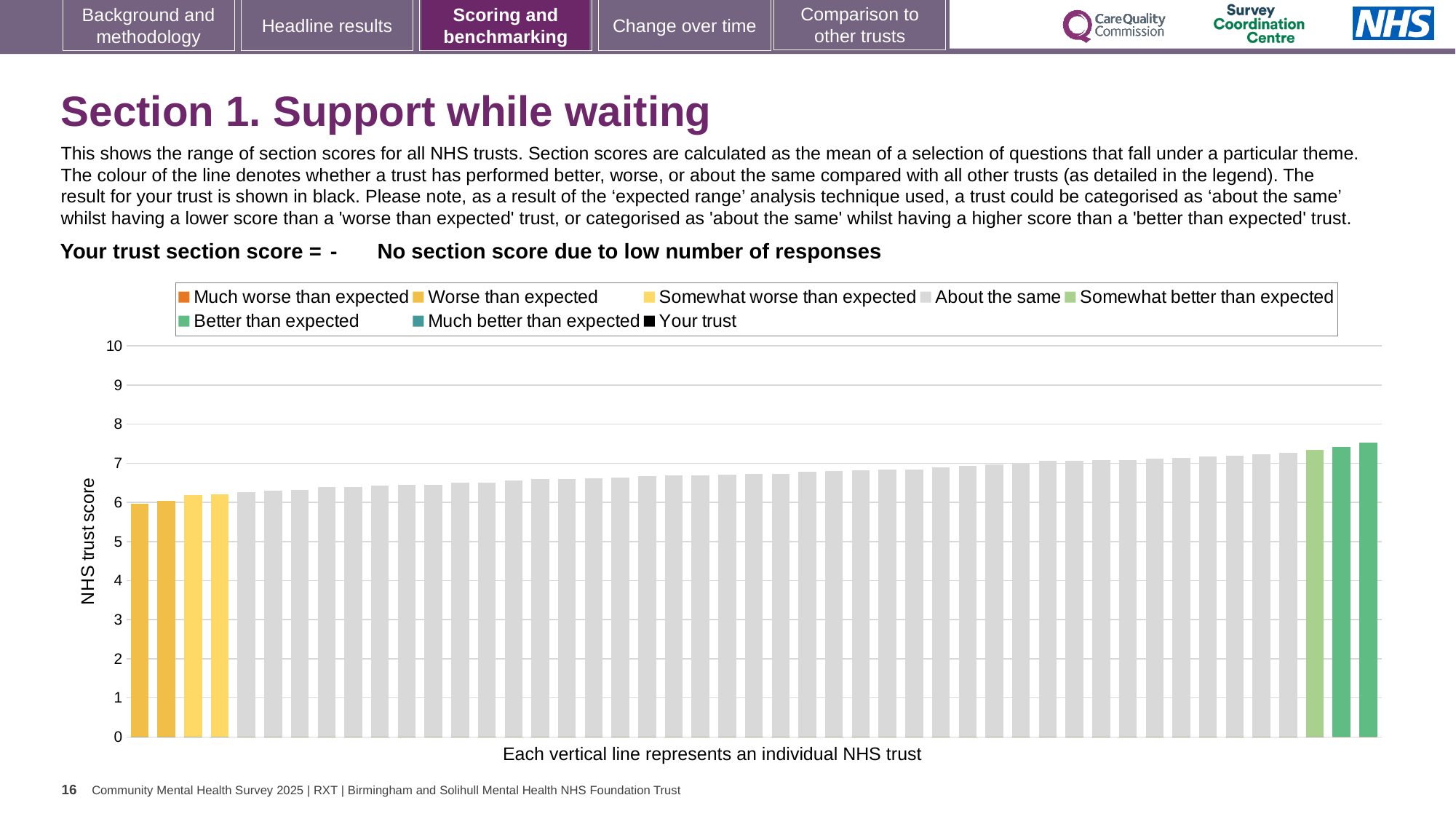
What kind of chart is shown on the slide? bar chart Is the lowest bar at the left end or the right end of the chart? left end Do the bar values rise or fall from left to right across the chart? rise Is the value of the leftmost bar greater or less than 7? less How many entries does the chart legend list? 8 Is the value of the rightmost bar greater or less than 7? greater What is the label on the vertical axis of the chart? NHS trust score According to the legend, what colour represents 'Your trust'? black Is the value of the highest bar greater or less than 8? less Is the highest bar at the left end or the right end of the chart? right end